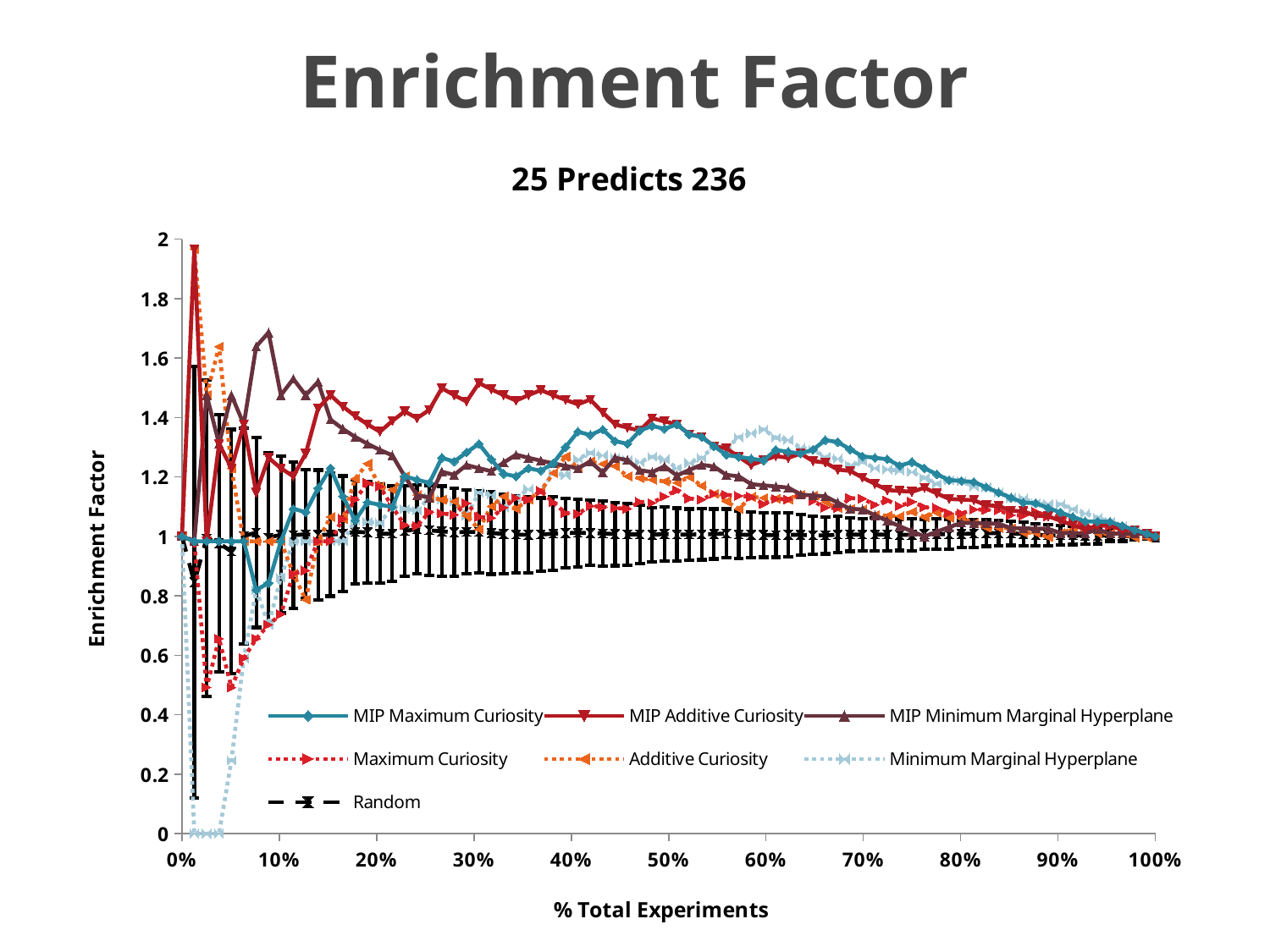
How many series does the legend list? 7 At 30% total experiments, which is larger: MIP Additive Curiosity or Random? MIP Additive Curiosity Is the value for Minimum Marginal Hyperplane at 3% greater or less than 0.2? less What is the label of the x axis? % Total Experiments Is the value for MIP Minimum Marginal Hyperplane at 10% greater or less than 1.4? greater What is the title printed above the chart's plot area? 25 Predicts 236 Is the value for Maximum Curiosity at 10% greater or less than 0.8? less What kind of chart is shown on the slide? line chart Does the MIP Additive Curiosity line rise or fall between 50% and 100% total experiments? fall What value do all the series converge to at 100% total experiments? 1